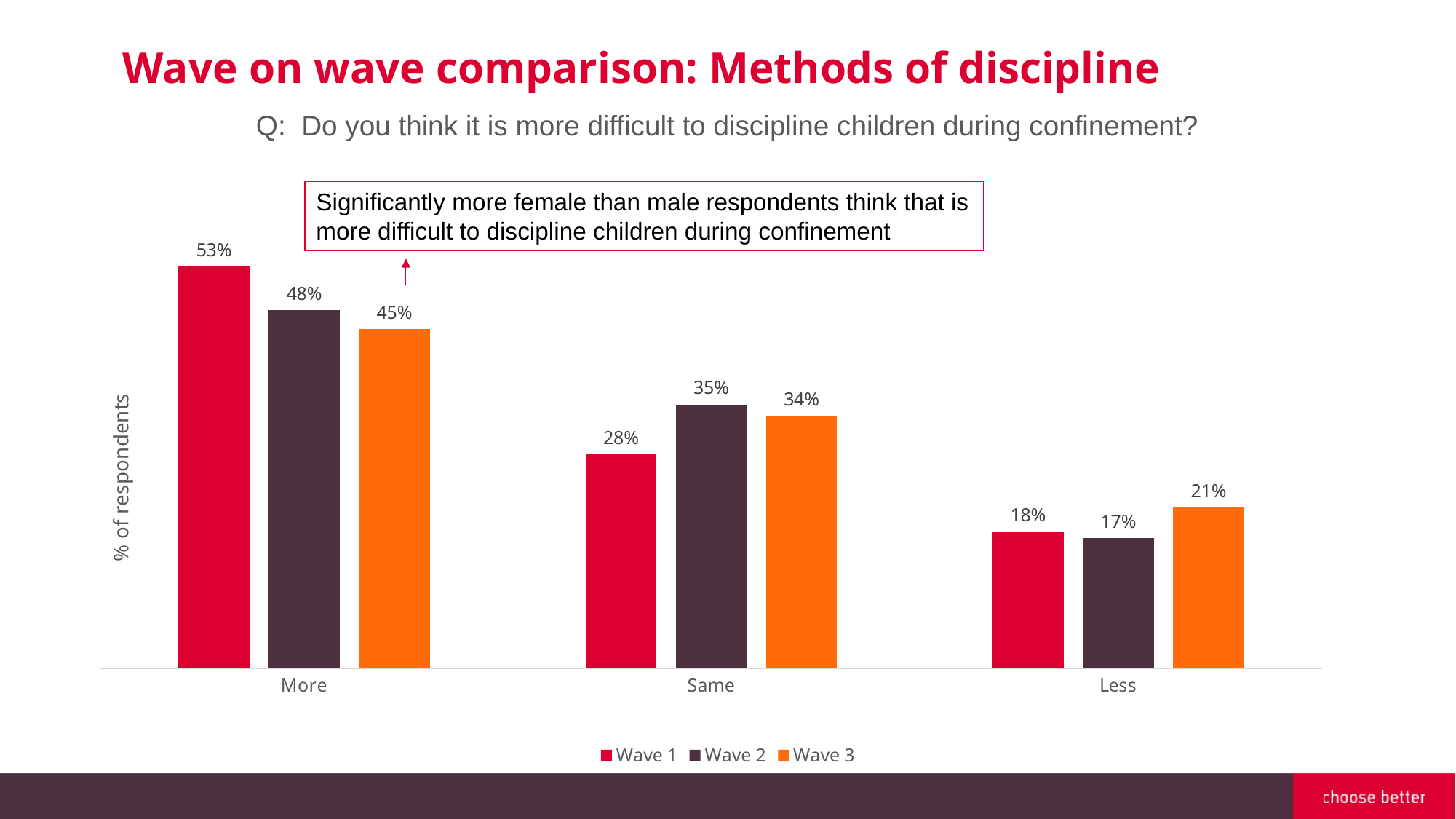
What is the label on the vertical axis? % of respondents What is the Wave 3 value for the "Same" category? 34% What percentage of respondents answered "More" in Wave 1? 53% How many series does the legend list? 3 What kind of chart is shown on the slide? Bar chart What percentage of respondents answered "Less" in Wave 2? 17% How many response categories are shown on the x axis? 3 What is the difference between the Wave 1 and Wave 3 values for "More"? 8% Which category has the lowest Wave 3 value? Less For the "Less" category, which wave has the larger value: Wave 1 or Wave 3? Wave 3 What is the difference between the Wave 2 and Wave 1 values for "Same"? 7% Which category has the highest Wave 1 value? More